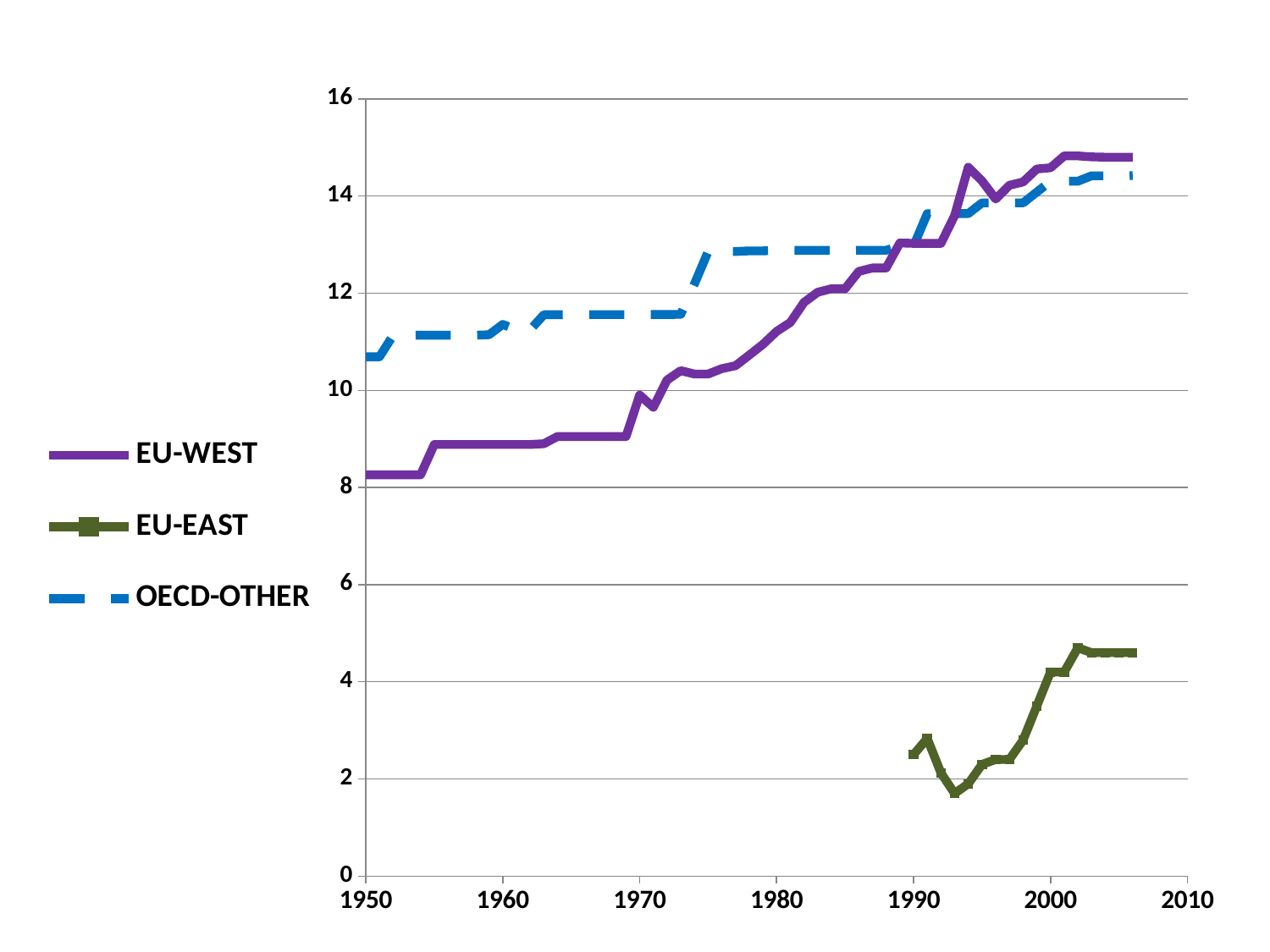
In 2000, which series has the higher value, EU-EAST or EU-WEST? EU-WEST Is the value for EU-EAST in 2005 greater or less than 4? greater Is the value for OECD-OTHER in 1980 greater or less than 12? greater What kind of chart is shown on the slide? line chart Which series is drawn with a dashed line? OECD-OTHER Is the value for EU-WEST in 2005 greater or less than 14? greater Does the EU-WEST line generally rise or fall from 1950 to 2006? rise How many series does the legend list? 3 In 1960, which series has the higher value, EU-WEST or OECD-OTHER? OECD-OTHER Which series has the lowest values on the chart? EU-EAST